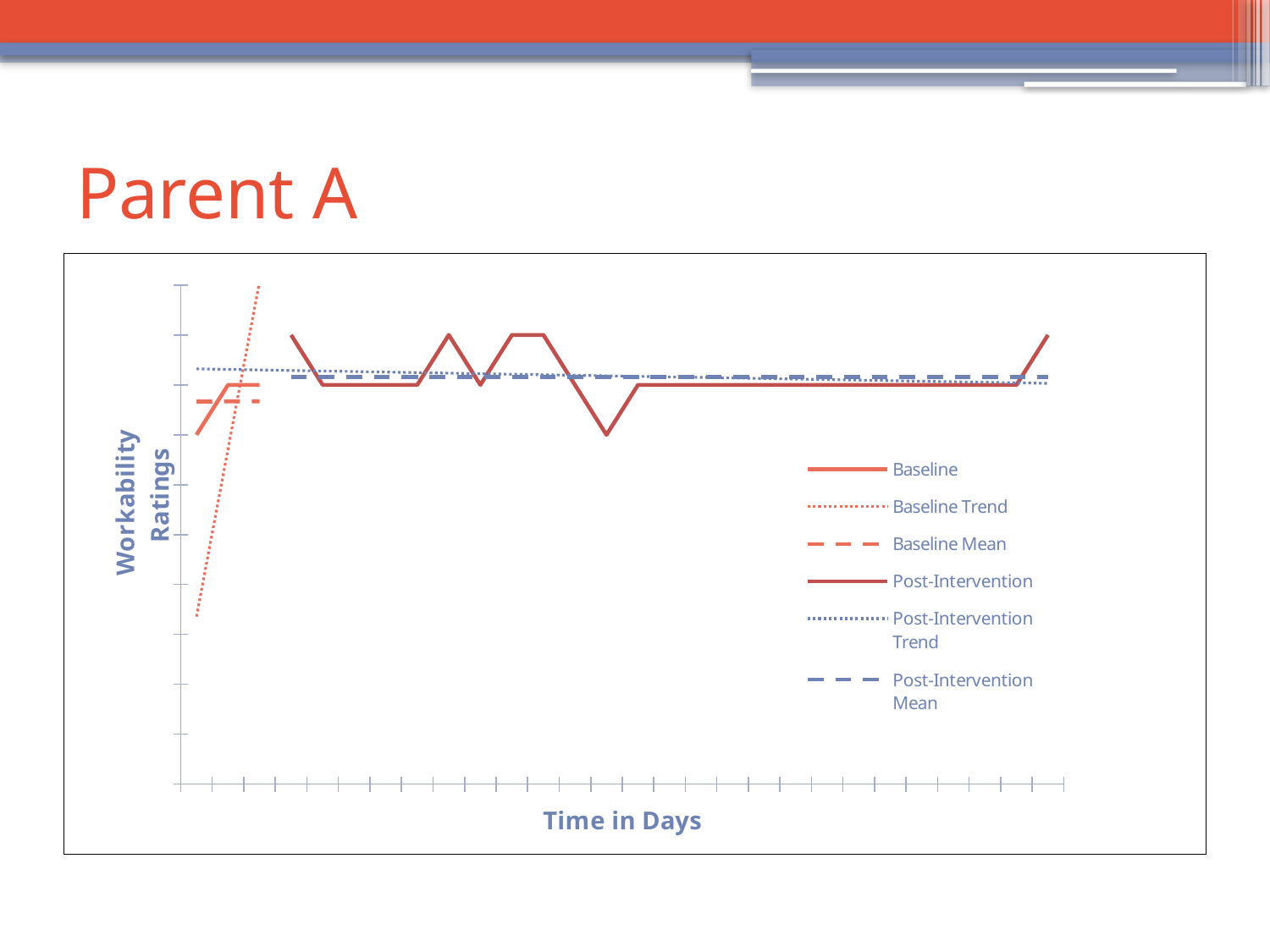
Which is higher, the Baseline Mean or the Post-Intervention Mean? Post-Intervention Mean What is the title of the horizontal axis? Time in Days What is the title of the vertical axis? Workability Ratings What kind of chart is shown on the slide? line chart How many series does the legend list? 6 How many data points does the Baseline series have? 3 Does the Baseline Trend line rise or fall along the x axis? rise Does the Post-Intervention Trend line rise or fall along the x axis? fall Does the Baseline series rise or fall along the x axis? rise